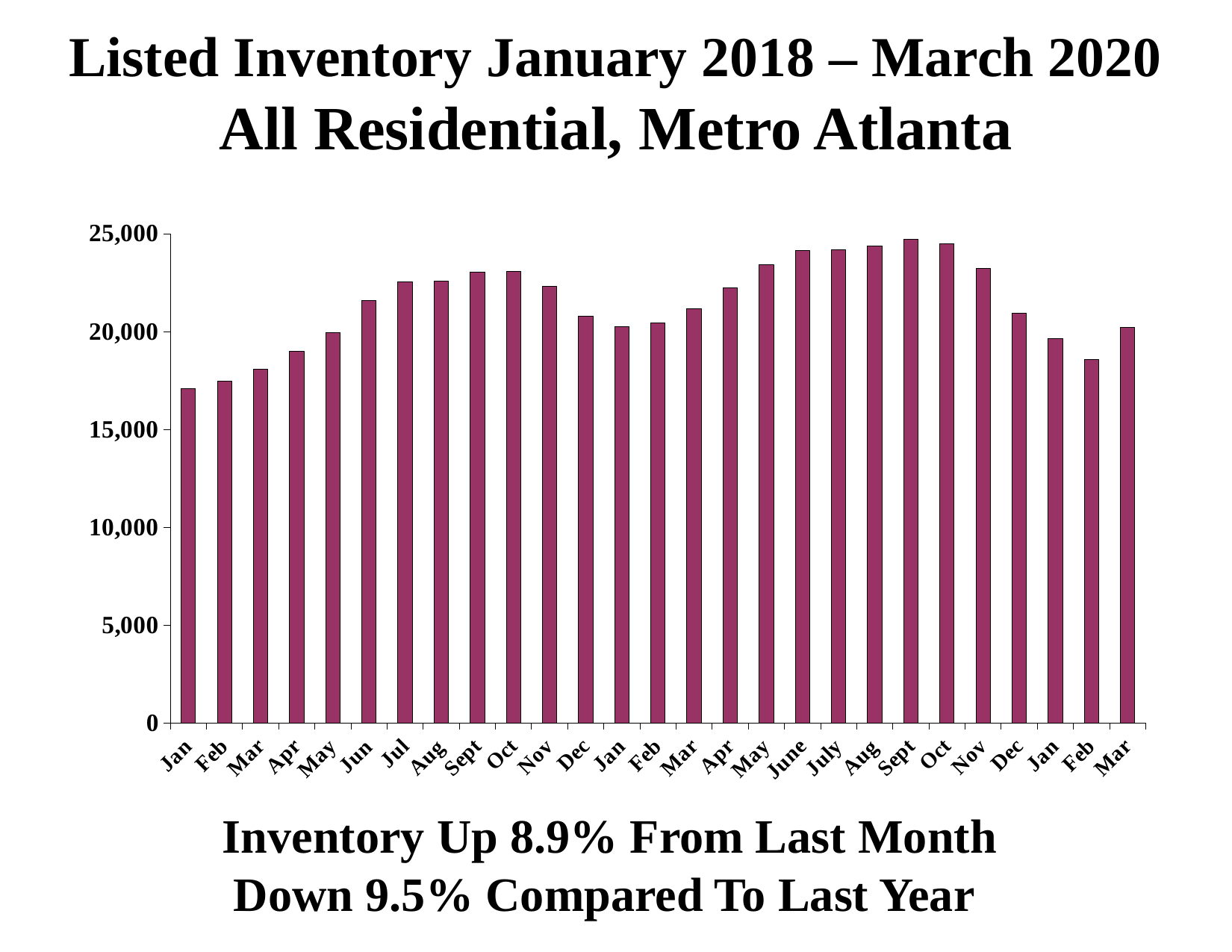
Is the listed inventory for Jan 2018 greater or less than 20,000? less According to the text below the chart, by what percentage is inventory down compared to last year? 9.5% Which is larger, the listed inventory for Jan 2018 or for Jan 2019? Jan 2019 Do the listed inventory values rise or fall from Jan 2018 to Sept 2018? rise Which is larger, the listed inventory for Feb 2019 or for Feb 2020? Feb 2019 How many monthly bars are plotted in the chart? 27 What kind of chart is shown on the slide? bar chart Do the listed inventory values rise or fall from Sept 2019 to Feb 2020? fall Is the listed inventory for Feb 2020 greater or less than 20,000? less Which month has the lowest listed inventory in the chart? Jan 2018 Is the listed inventory for Jun 2018 greater or less than 20,000? greater